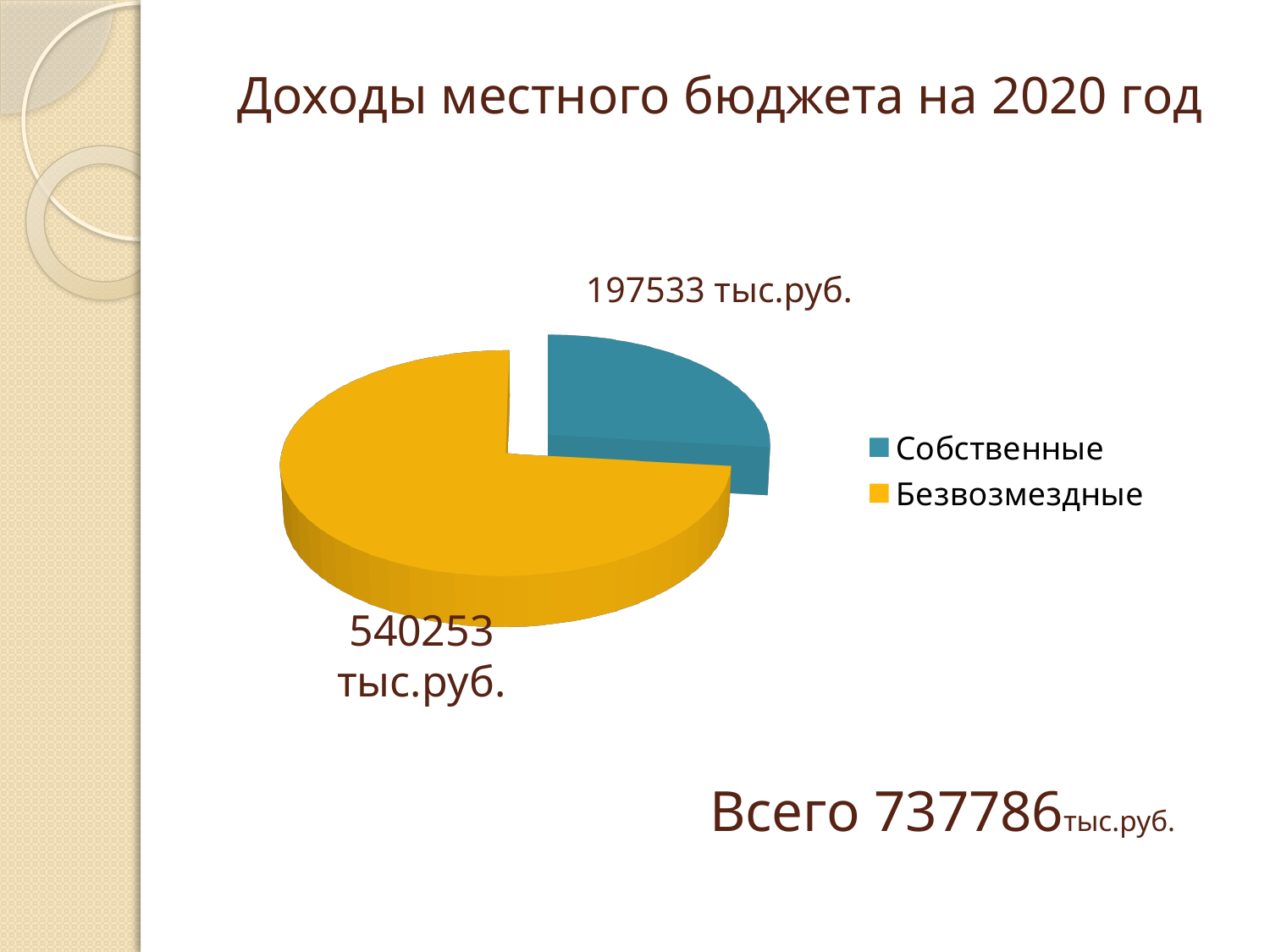
What is the difference between Безвозмездные and Собственные? 342720 тыс.руб. What is the value for Безвозмездные? 540253 тыс.руб. Which category has the smallest slice of the pie? Собственные How many entries does the legend list? 2 What type of chart is shown on the slide? Pie chart How many slices does the pie chart have? 2 What is the title of the slide? Доходы местного бюджета на 2020 год What is the value for Собственные? 197533 тыс.руб. What colour is the Безвозмездные slice? Yellow What is the total of the two slices shown on the slide? 737786 тыс.руб. Which category has the largest slice of the pie? Безвозмездные Which is larger, Собственные or Безвозмездные? Безвозмездные